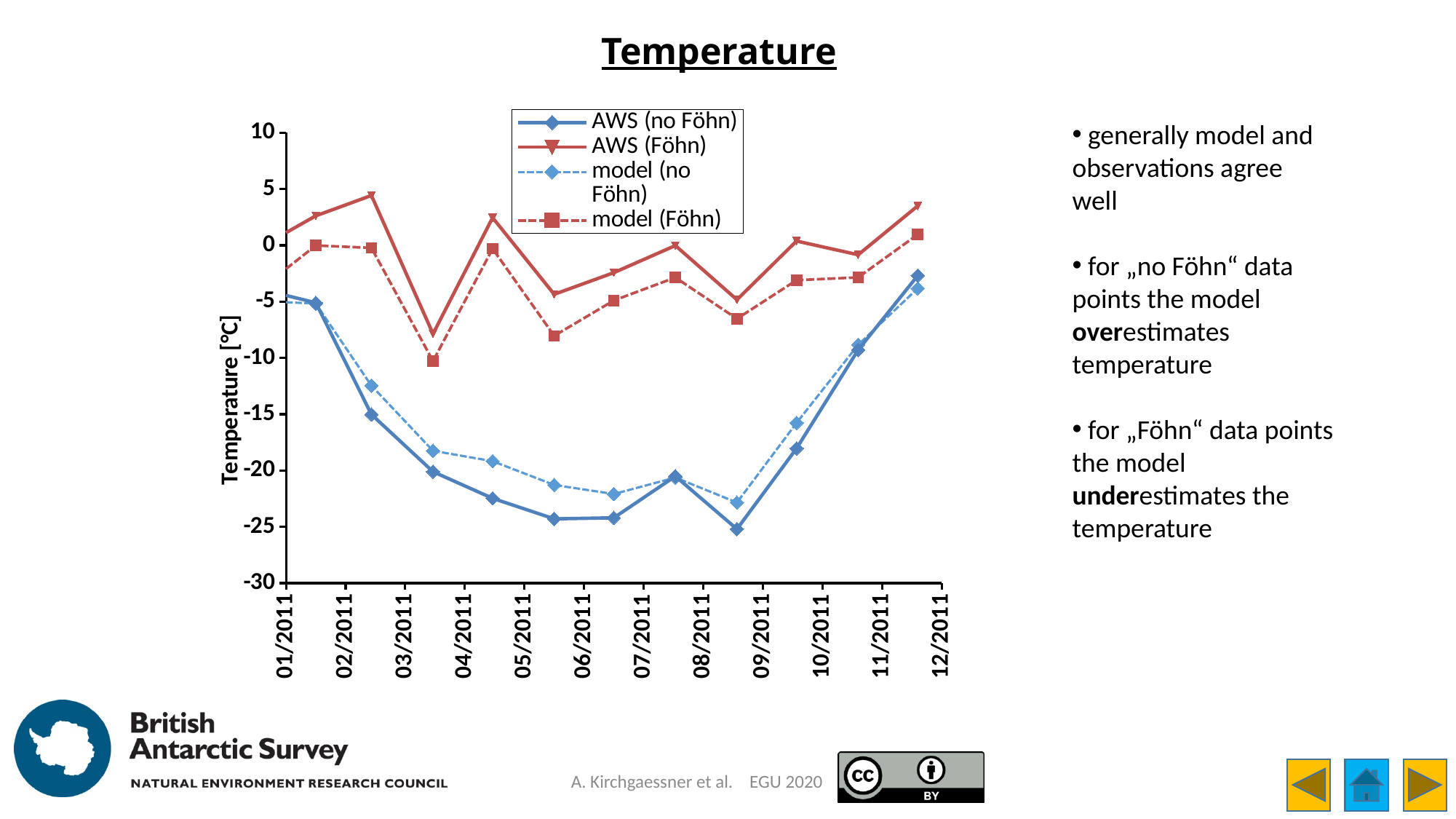
Which series is drawn with a dashed red line and square markers? model (Föhn) How many month labels are shown along the x axis? 12 Which series reaches the highest temperature on the chart? AWS (Föhn) Around 03/2011, which series is higher: AWS (Föhn) or AWS (no Föhn)? AWS (Föhn) Does the AWS (no Föhn) series rise or fall between 01/2011 and 06/2011? fall Is the highest value of the AWS (Föhn) series greater or less than 0? greater Is the value of the AWS (no Föhn) series at 01/2011 greater or less than -10? greater Which series reaches the lowest temperature on the chart? AWS (no Föhn) How many series does the legend list? 4 What is the label of the y axis? Temperature [°C] Is the lowest value of the AWS (no Föhn) series greater or less than -20? less What kind of chart is shown on the slide? line chart